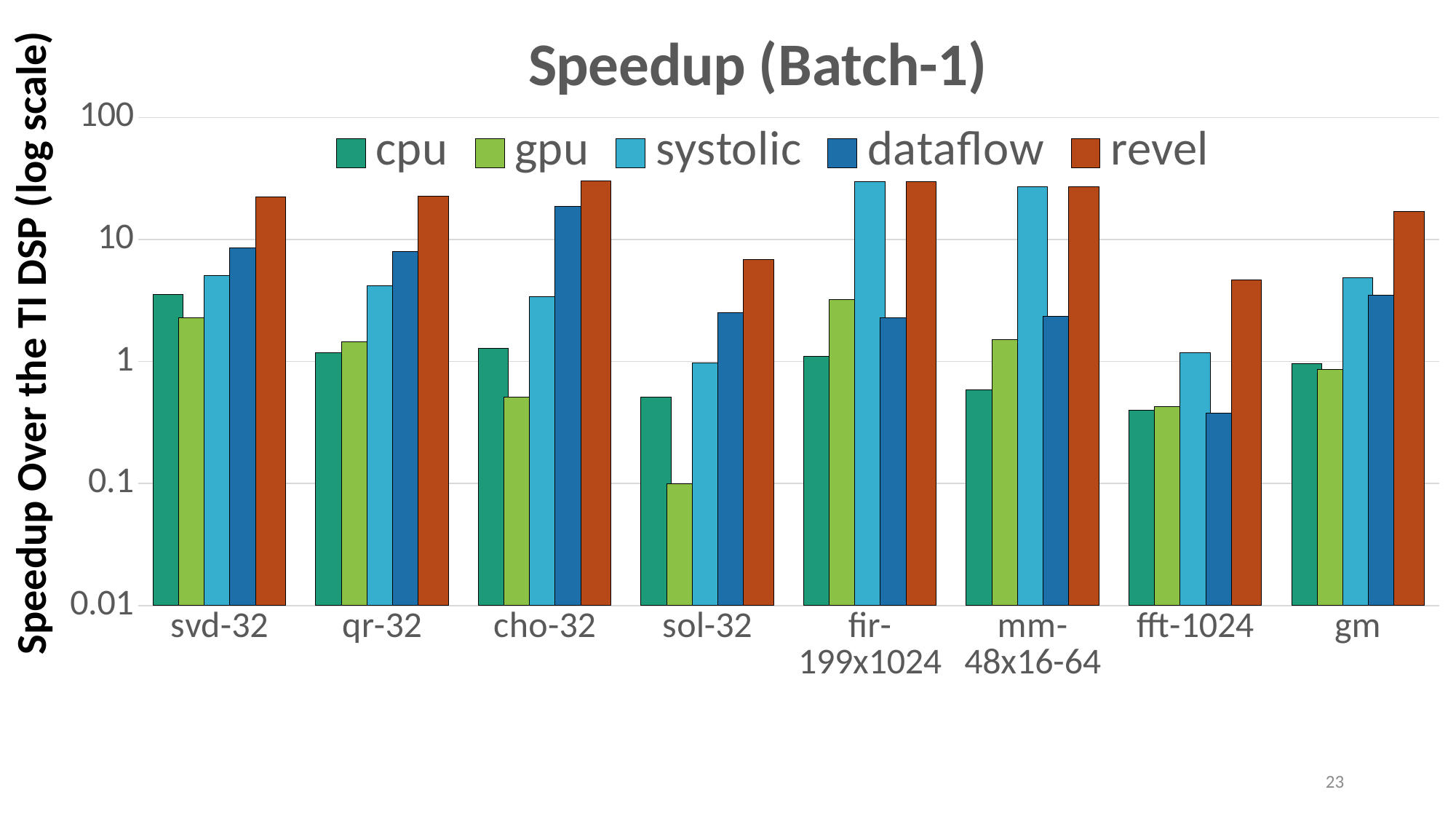
How many series does the legend list? 5 What is the label of the y axis? Speedup Over the TI DSP (log scale) What is the title of the chart? Speedup (Batch-1) Which is larger for cho-32, the dataflow value or the systolic value? dataflow Which series has the highest value for fft-1024? revel Is the value for revel on svd-32 greater or less than 10? greater Which series has the lowest value for cho-32? gpu What kind of chart is shown on the slide? bar chart Which series has the lowest value for sol-32? gpu Which series has the highest value for svd-32? revel Is the value for cpu on fft-1024 greater or less than 1? less How many benchmark categories are shown on the x axis? 8